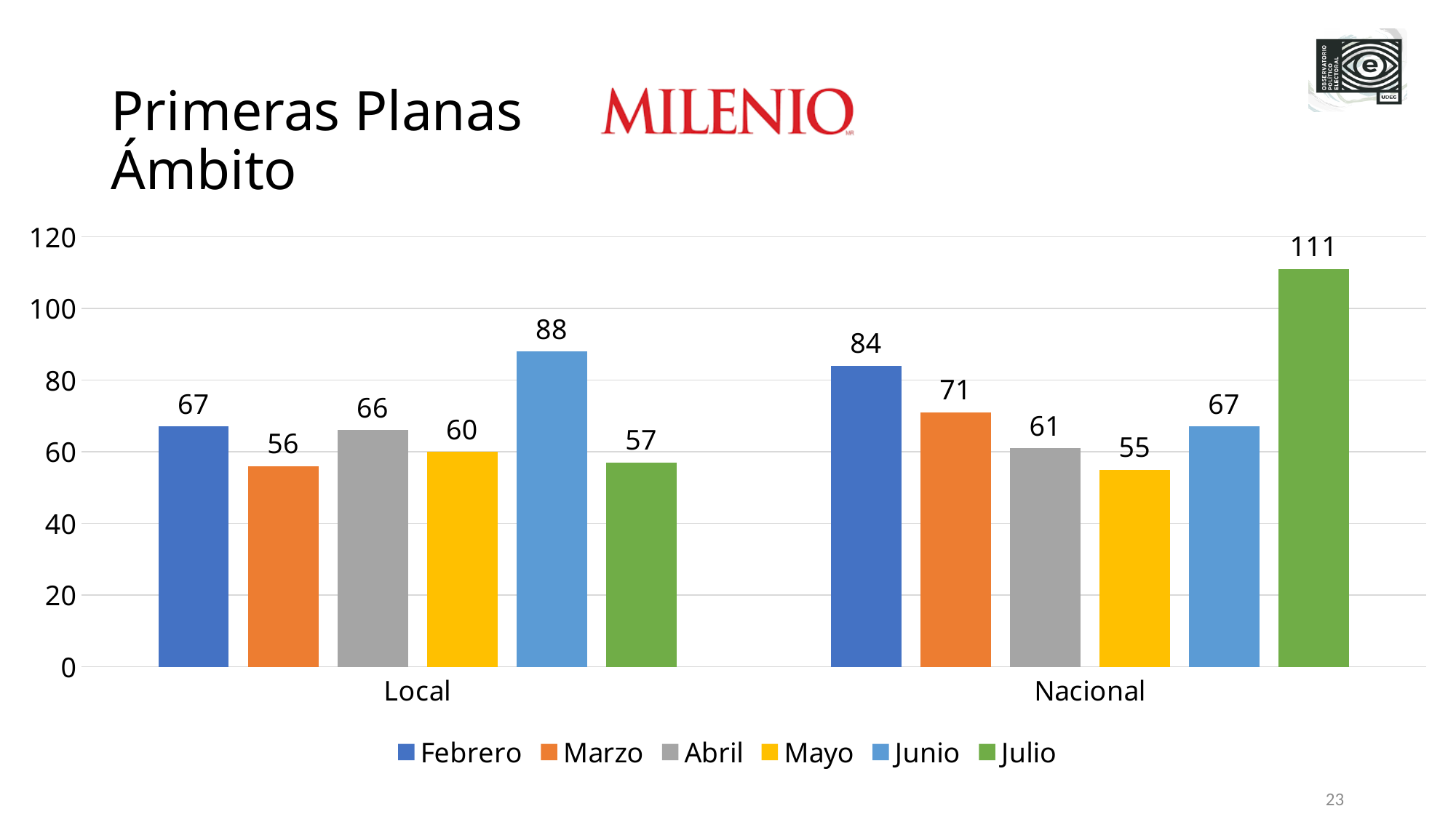
Which month has the highest value in the Nacional category? Julio What is the value for Julio in the Nacional category? 111 What is the difference between the Julio values for Nacional and Local? 54 Is the value for Junio in the Nacional category greater or less than 80? less Which colour represents Mayo in the legend? yellow Which month has the lowest value in the Local category? Marzo How many series does the legend list? 6 What is the value for Mayo in the Nacional category? 55 What is the value for Junio in the Local category? 88 How many categories are shown on the x axis? 2 What kind of chart is shown on the slide? bar chart Which is larger, the Febrero value for Local or the Febrero value for Nacional? Nacional